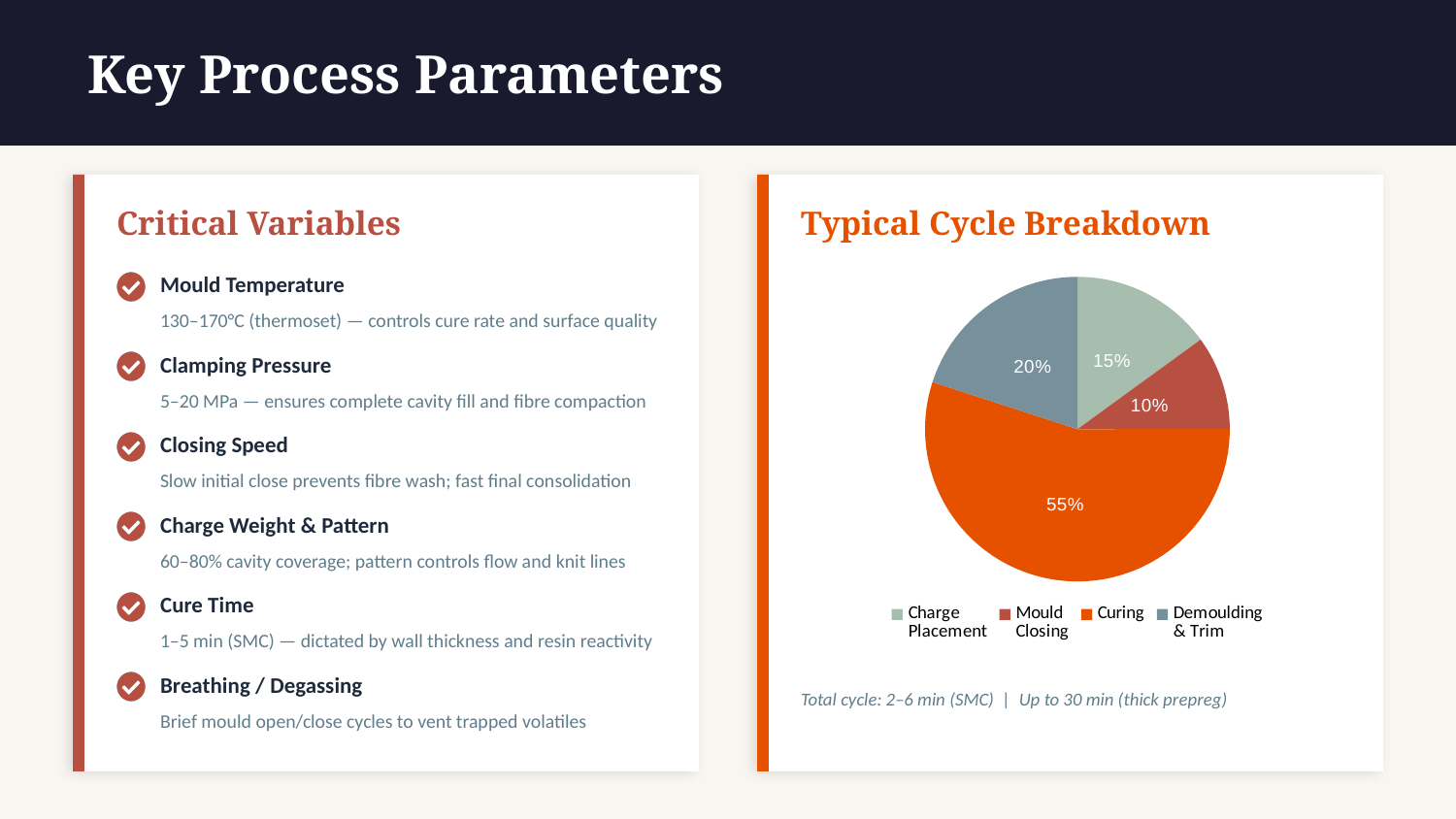
What is the difference in percentage points between Curing and Demoulding & Trim in the pie chart? 35 What colour is the Curing slice in the pie chart? Orange Which stage takes the largest share of the cycle in the pie chart? Curing What is the combined share of Charge Placement and Mould Closing in the pie chart? 25% What percentage is shown for Mould Closing in the pie chart? 10% What kind of chart is shown under "Typical Cycle Breakdown"? Pie chart What percentage is shown for Demoulding & Trim in the pie chart? 20% How many slices does the pie chart have? 4 What percentage is shown for Charge Placement in the pie chart? 15% Which stage takes the smallest share of the cycle in the pie chart? Mould Closing What share of the cycle does Curing take in the pie chart? 55% Which is larger in the pie chart, Charge Placement or Mould Closing? Charge Placement